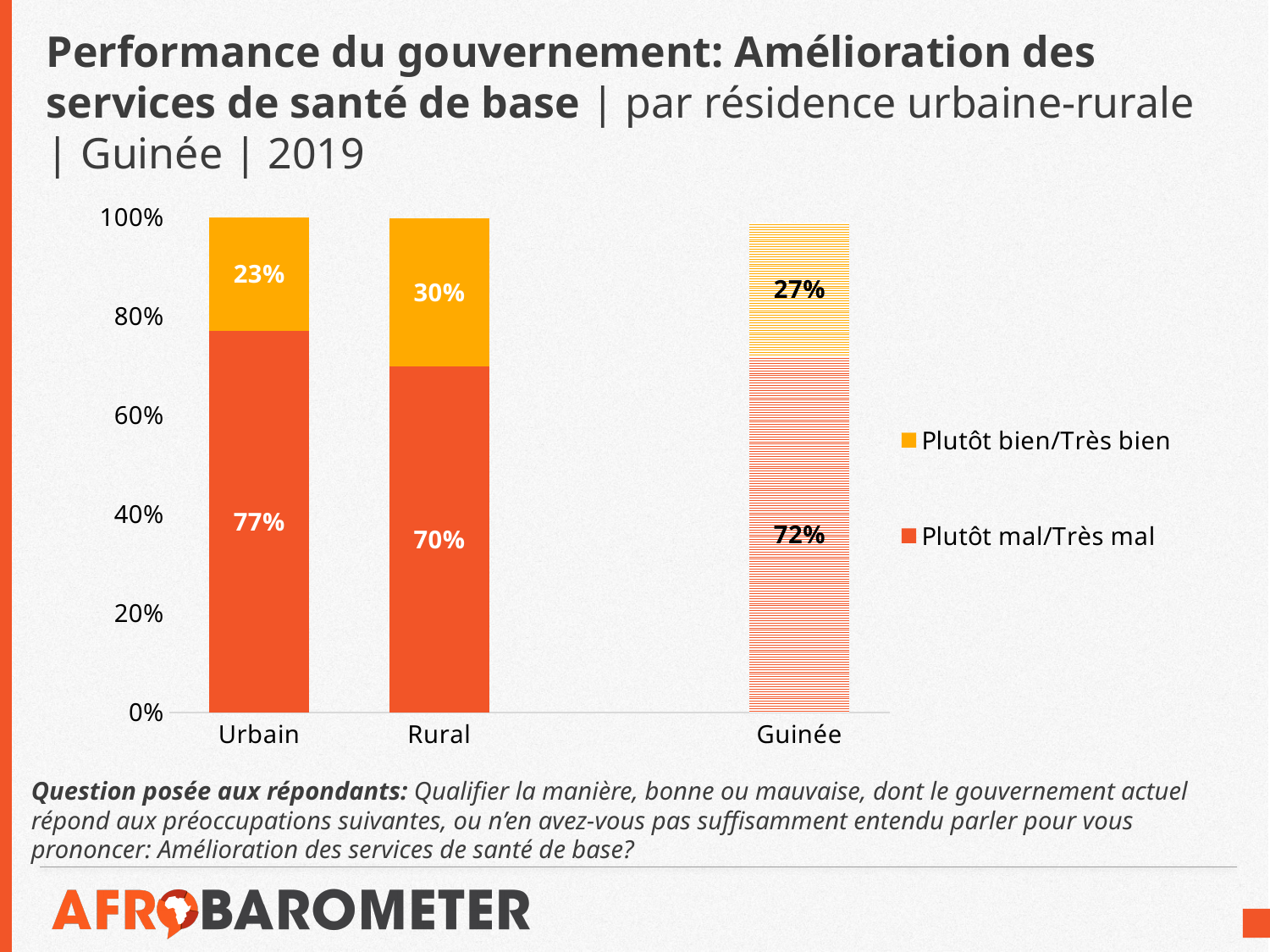
Which is larger: the 'Plutôt bien/Très bien' value for Rural or for Guinée? Rural What is the 'Plutôt mal/Très mal' value for Guinée overall? 72% How many series does the legend list? 2 What percentage of urban respondents rated the government 'Plutôt mal/Très mal' on improving basic health services? 77% What is the difference between the 'Plutôt mal/Très mal' values for Urbain and Rural? 7 percentage points What is the 'Plutôt bien/Très bien' value for Urbain? 23% What is the 'Plutôt bien/Très bien' value for Rural? 30% Which category has the lowest 'Plutôt bien/Très bien' value? Urbain How many categories are shown on the x axis? 3 What is the total of the stacked bar for Urbain? 100% What kind of chart is shown on the slide? Stacked bar chart Which category has the highest 'Plutôt mal/Très mal' value? Urbain